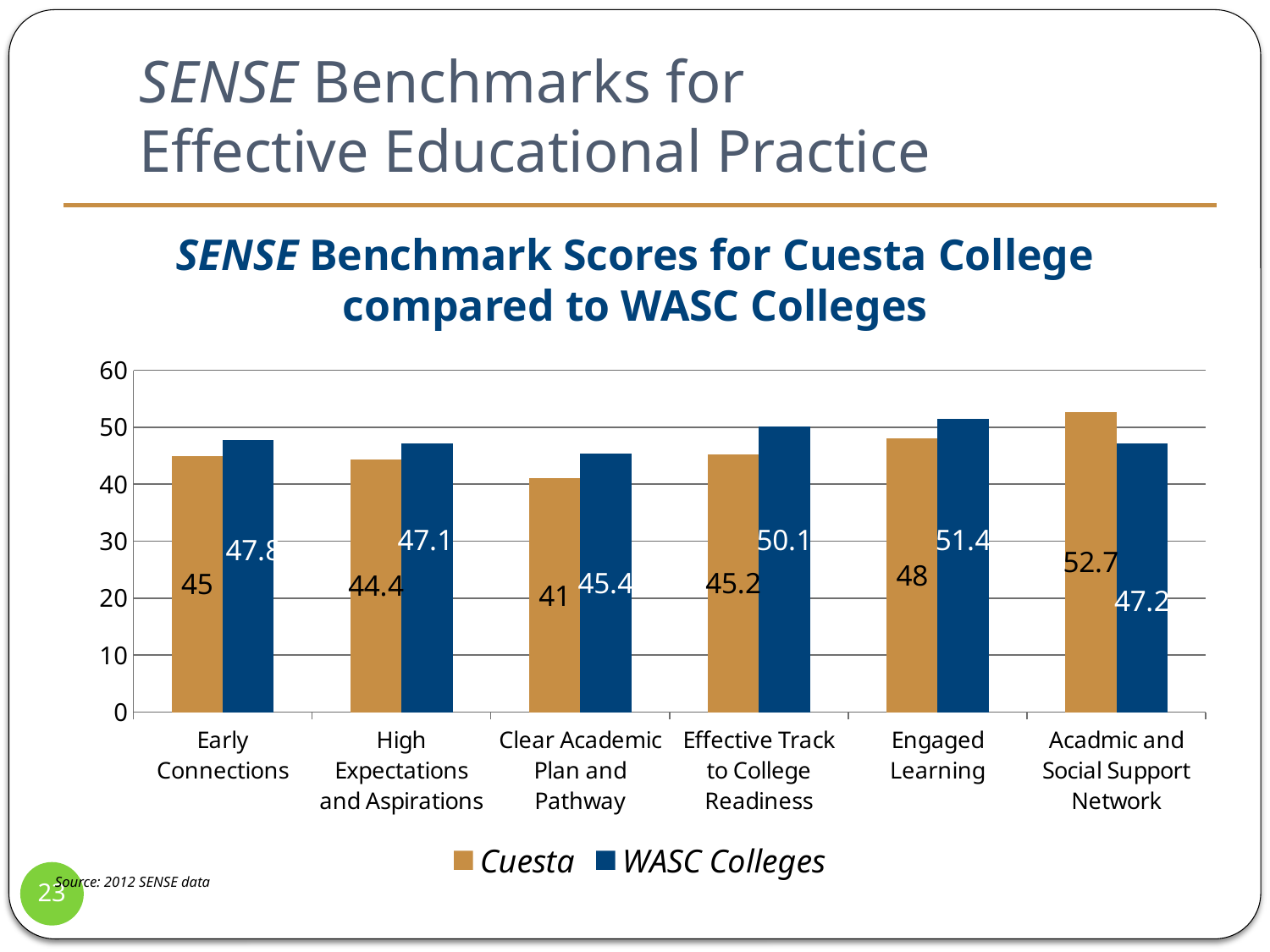
What kind of chart is shown on the slide? bar chart Which benchmark has the lowest WASC Colleges score? Clear Academic Plan and Pathway What is the WASC Colleges score for Effective Track to College Readiness? 50.1 What is the Cuesta score for Early Connections? 45 How many benchmark categories are shown on the x axis? 6 What is the Cuesta score for Clear Academic Plan and Pathway? 41 Which benchmark has the highest Cuesta score? Acadmic and Social Support Network What is the difference between the WASC Colleges and Cuesta scores for Clear Academic Plan and Pathway? 4.4 Which colour represents WASC Colleges in the chart? dark blue Is the WASC Colleges score for Engaged Learning greater or less than 50? greater How many series does the legend list? 2 For Acadmic and Social Support Network, which is larger: the Cuesta score or the WASC Colleges score? Cuesta